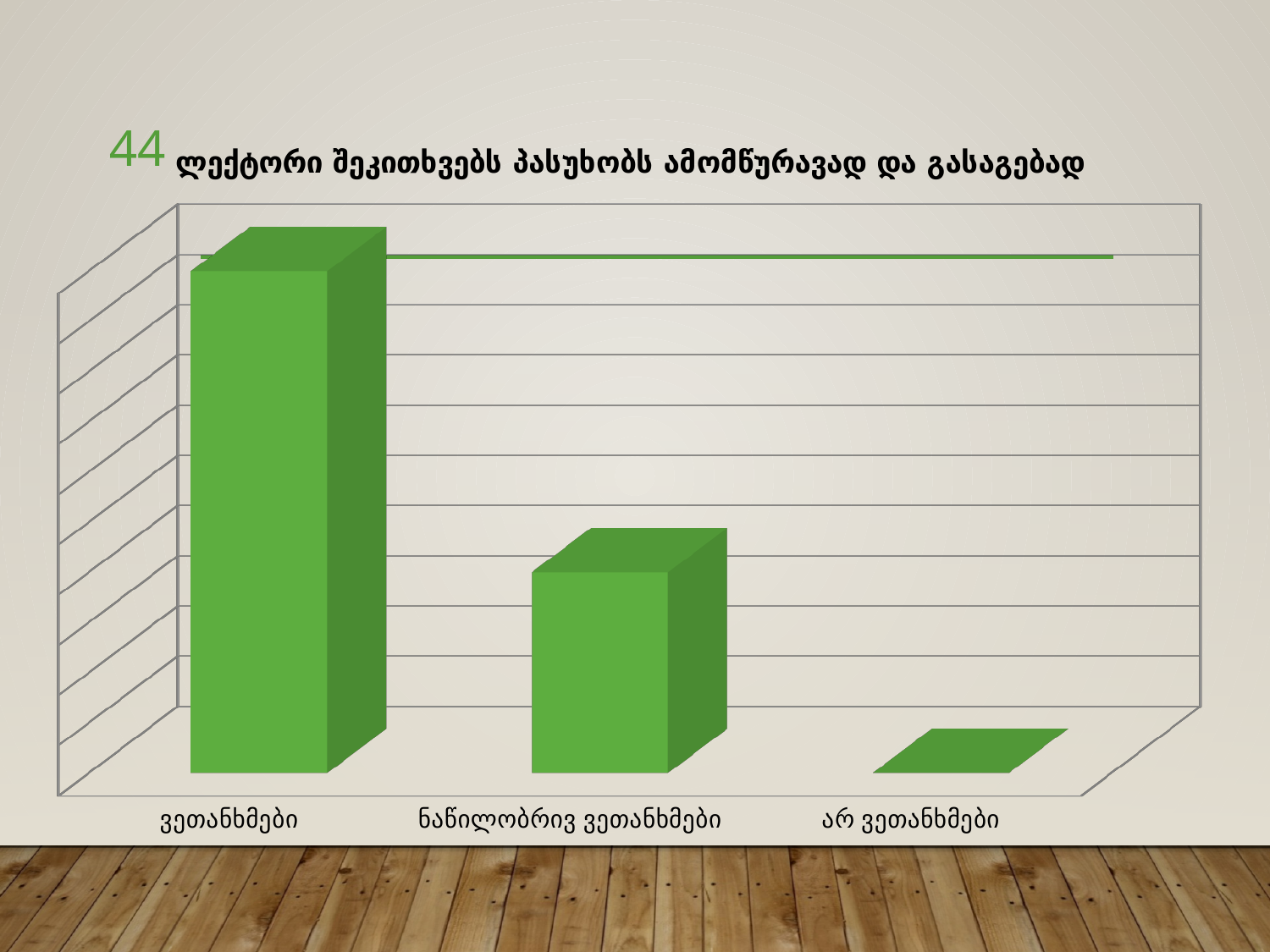
Which is larger, the bar for ნაწილობრივ ვეთანხმები or the bar for არ ვეთანხმები? ნაწილობრივ ვეთანხმები Which category has the lowest bar in the chart? არ ვეთანხმები How many categories are shown on the x axis of the chart? 3 Which is larger, the bar for ვეთანხმები or the bar for ნაწილობრივ ვეთანხმები? ვეთანხმები What colour are the bars in the chart? green Which category has the highest bar in the chart? ვეთანხმები Do the bar values rise or fall from left to right along the x axis? fall What kind of chart is shown on the slide? bar chart What is the title of the chart? ლექტორი შეკითხვებს პასუხობს ამომწურავად და გასაგებად What is the label of the middle category on the x axis? ნაწილობრივ ვეთანხმები